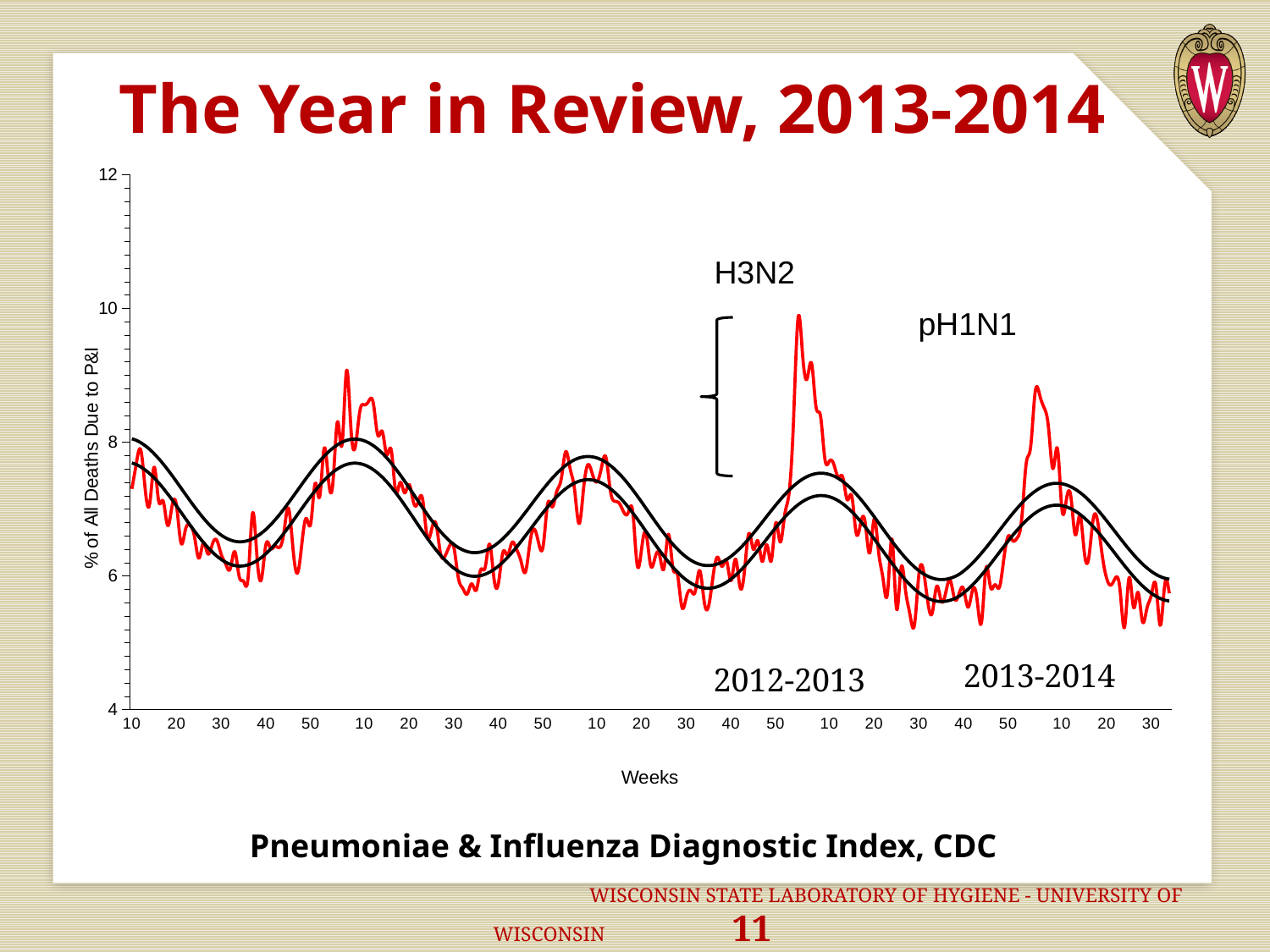
How many smooth black curves are plotted on the chart? 2 Is the lowest point of the red line in the 2013-2014 season greater or less than 6? less Does the red line rise or fall between week 10 and week 30 at the left end of the chart? fall How many seasons are labelled by year on the chart? 2 Which season has the higher peak of the red line, 2012-2013 or 2013-2014? 2012-2013 What is the title of the chart? Pneumoniae & Influenza Diagnostic Index, CDC What kind of chart is shown on the slide? line chart Is the highest peak of the red line in the 2013-2014 season greater or less than 10? less Is the value of the red line at the leftmost point of the chart (week 10) greater or less than 7? greater What is the label on the vertical axis of the chart? % of All Deaths Due to P&I